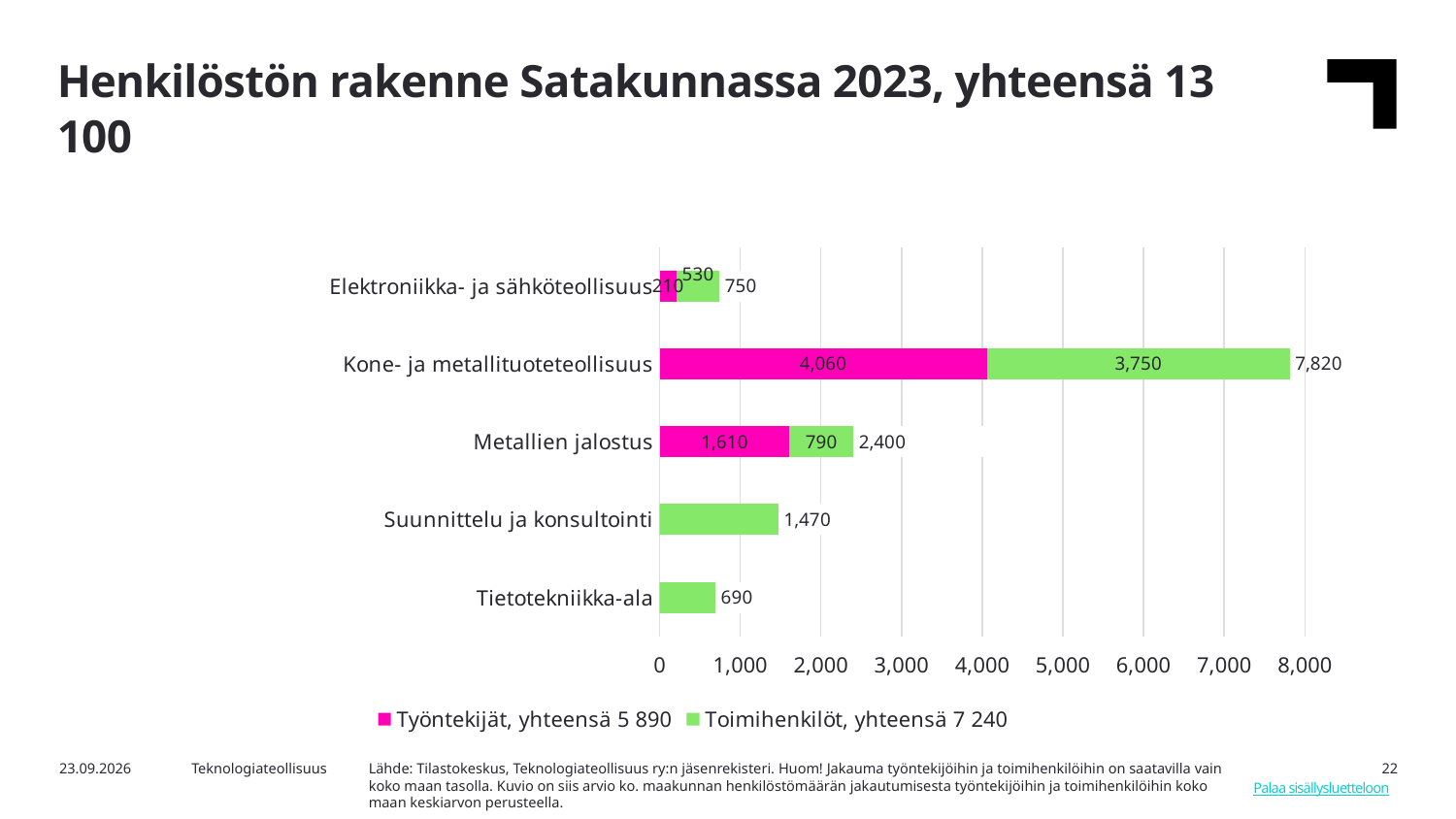
What is the Toimihenkilöt value for Elektroniikka- ja sähköteollisuus? 530 How many series does the legend list? 2 What is the Toimihenkilöt value for Metallien jalostus? 790 How many categories are shown on the chart? 5 What is the total of the bar for Metallien jalostus? 2,400 What is the total of the bar for Kone- ja metallituoteteollisuus? 7,820 What kind of chart is shown on the slide? stacked bar chart What is the difference between the Työntekijät and Toimihenkilöt values for Kone- ja metallituoteteollisuus? 310 Which category has the shortest bar? Tietotekniikka-ala Which is larger: the total for Suunnittelu ja konsultointi or the total for Elektroniikka- ja sähköteollisuus? Suunnittelu ja konsultointi Which category has the longest bar? Kone- ja metallituoteteollisuus What is the Työntekijät value for Kone- ja metallituoteteollisuus? 4,060